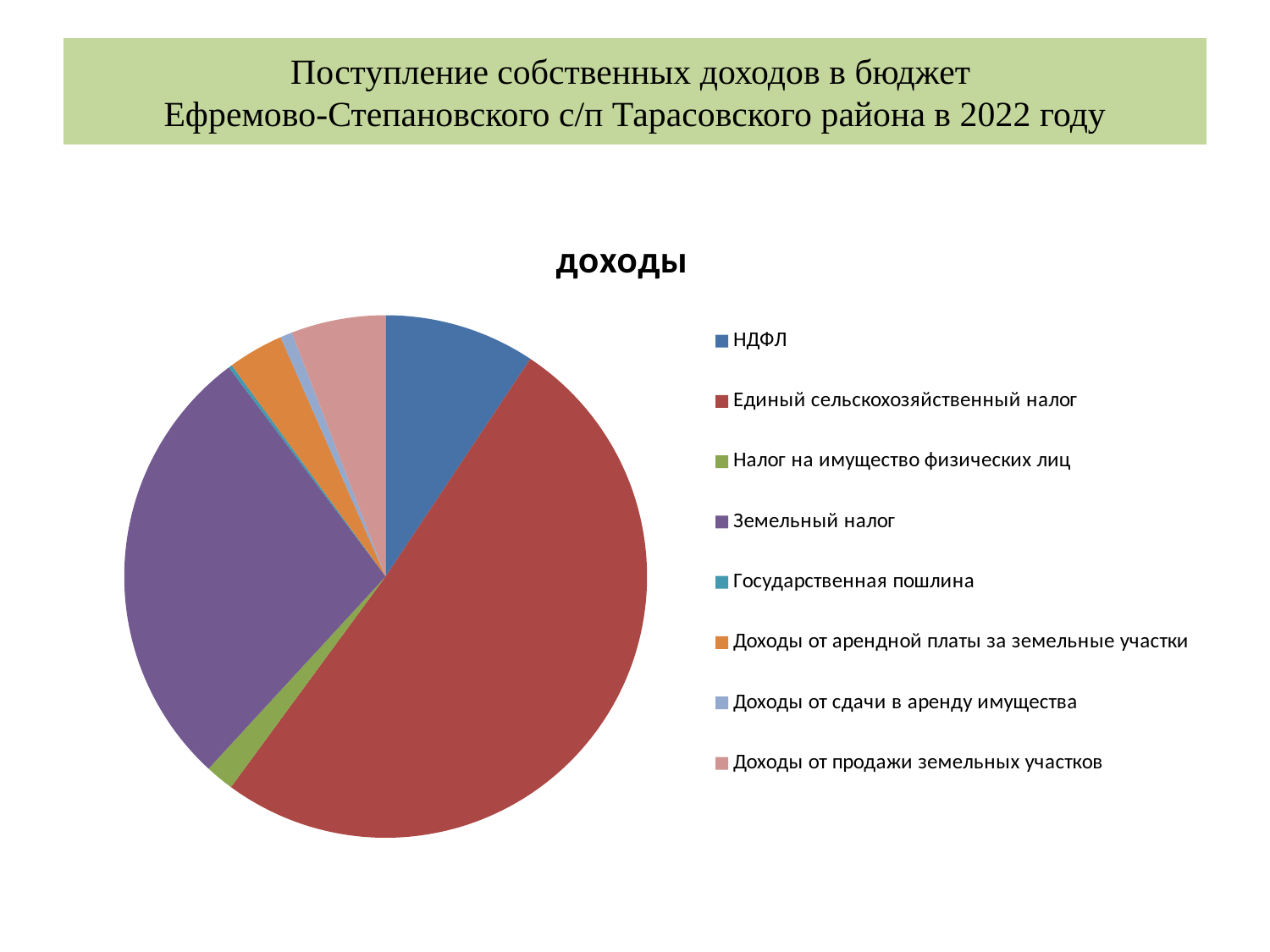
Which category has the smallest slice of the pie? Государственная пошлина Which is larger: the slice for Доходы от продажи земельных участков or the slice for Доходы от сдачи в аренду имущества? Доходы от продажи земельных участков How many categories does the pie chart have? 8 Which category has the largest slice of the pie? Единый сельскохозяйственный налог Which is larger: the slice for Единый сельскохозяйственный налог or the slice for Земельный налог? Единый сельскохозяйственный налог Which category is the second-largest slice of the pie? Земельный налог Which category is shown in purple in the pie chart? Земельный налог Which is larger: the slice for Доходы от арендной платы за земельные участки or the slice for Налог на имущество физических лиц? Доходы от арендной платы за земельные участки What is the title of the chart? доходы What kind of chart is shown on the slide? pie chart